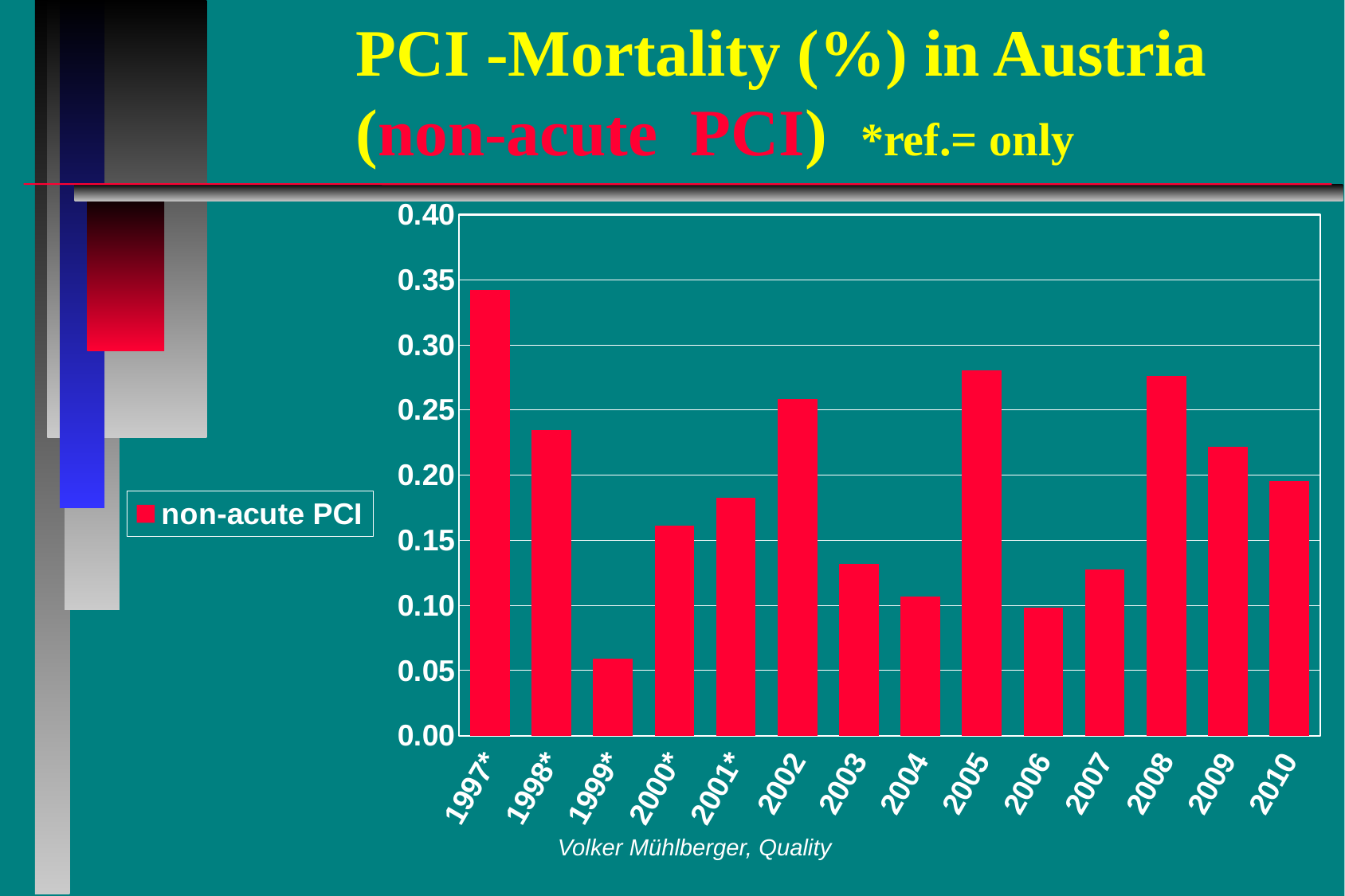
Is the value for 1999* greater or less than 0.10? less Which year has the lowest non-acute PCI mortality? 1999* Is the value for 2007 greater or less than 0.15? less How many years are shown on the x axis of the chart? 14 What series name is shown in the chart legend? non-acute PCI How many series does the legend list? 1 Is the value for 1997* greater or less than 0.30? greater Which year has the highest non-acute PCI mortality? 1997* What kind of chart is shown on the slide? bar chart Which is larger, the value for 2002 or the value for 2009? 2002 Do the values rise or fall from 1997* to 1999*? fall